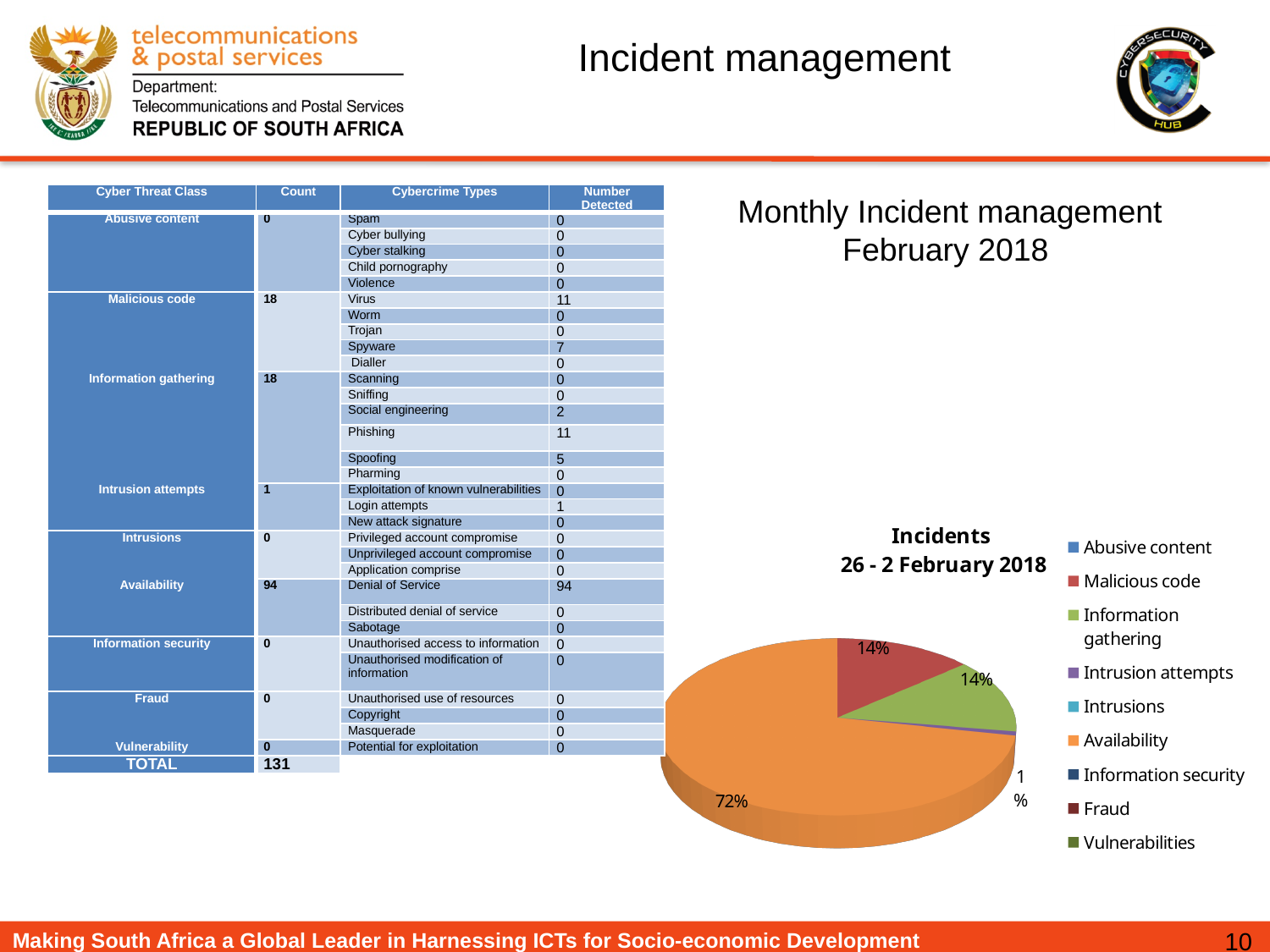
How many categories does the legend of the pie chart list? 9 What colour represents Availability in the pie chart? orange By how many percentage points does the Availability share exceed the Malicious code share? 58 What kind of chart is shown on the slide? pie chart What share of the pie does Malicious code account for? 14% Which is larger in the pie chart, Availability or Malicious code? Availability What share of the pie does Intrusion attempts account for? 1% What share of the pie does Availability account for? 72% What is the title of the pie chart? Incidents 26 - 2 February 2018 Which labelled category has the smallest slice of the pie? Intrusion attempts Which category has the largest slice of the pie? Availability